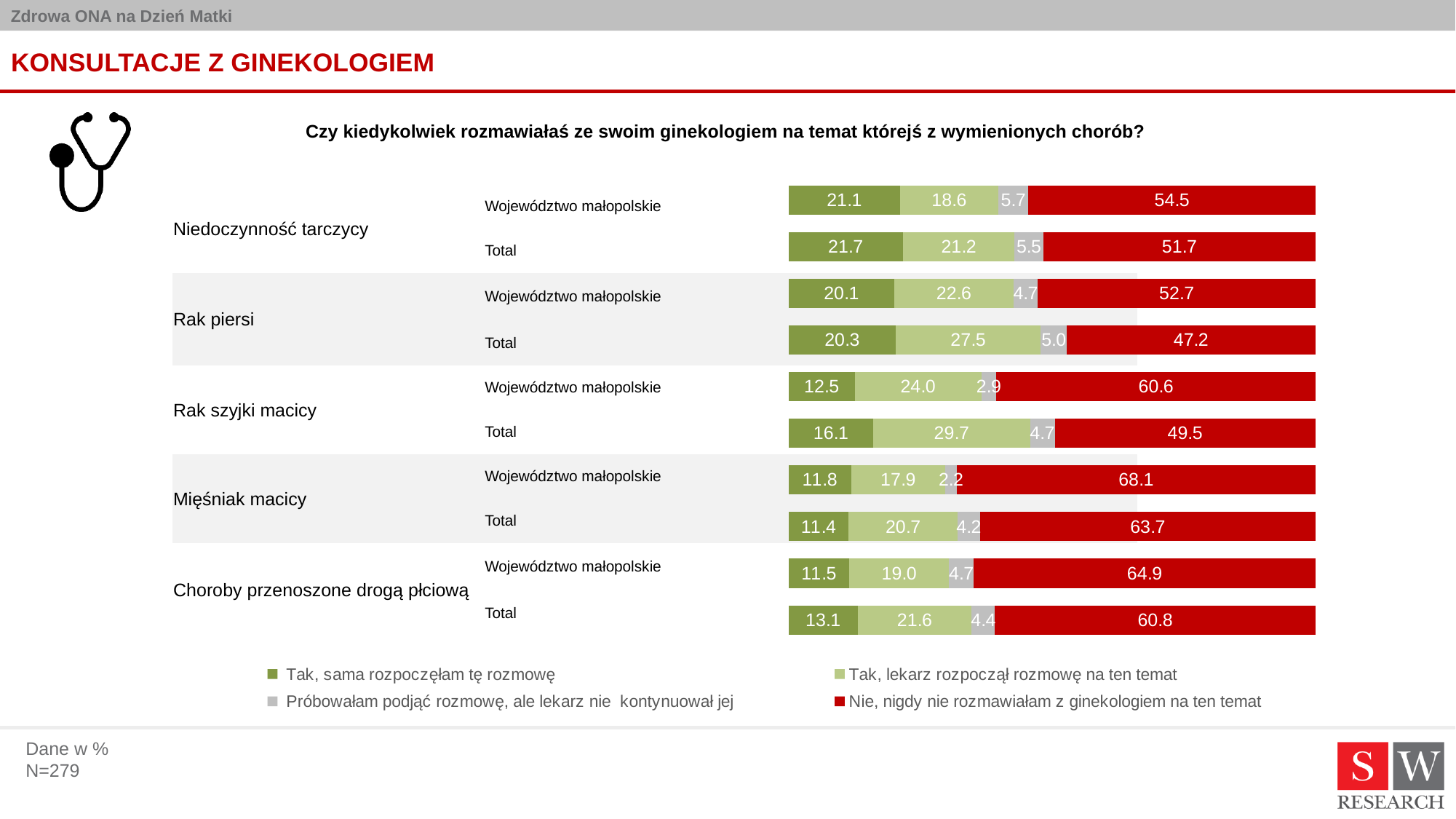
For Niedoczynność tarczycy, Województwo małopolskie, what is the value for "Nie, nigdy nie rozmawiałam z ginekologiem na ten temat"? 54.5 For Rak piersi, Total, what is the value for "Tak, lekarz rozpoczął rozmowę na ten temat"? 27.5 What colour represents "Nie, nigdy nie rozmawiałam z ginekologiem na ten temat" in the chart? Red What is the total of the Niedoczynność tarczycy, Województwo małopolskie bar? 99.9 What kind of chart is shown on the slide? Stacked bar chart For Choroby przenoszone drogą płciową, Total, what is the value for "Próbowałam podjąć rozmowę, ale lekarz nie kontynuował jej"? 4.4 Which is larger for "Tak, lekarz rozpoczął rozmowę na ten temat": Rak piersi Total or Niedoczynność tarczycy Total? Rak piersi Total How many bars are shown in the chart? 10 Which bar has the highest value for "Nie, nigdy nie rozmawiałam z ginekologiem na ten temat"? Mięśniak macicy, Województwo małopolskie For Rak szyjki macicy, what is the difference between the "Nie, nigdy nie rozmawiałam" values for Województwo małopolskie and Total? 11.1 Which bar has the lowest value for "Tak, sama rozpoczęłam tę rozmowę"? Mięśniak macicy, Total How many series does the legend list? 4